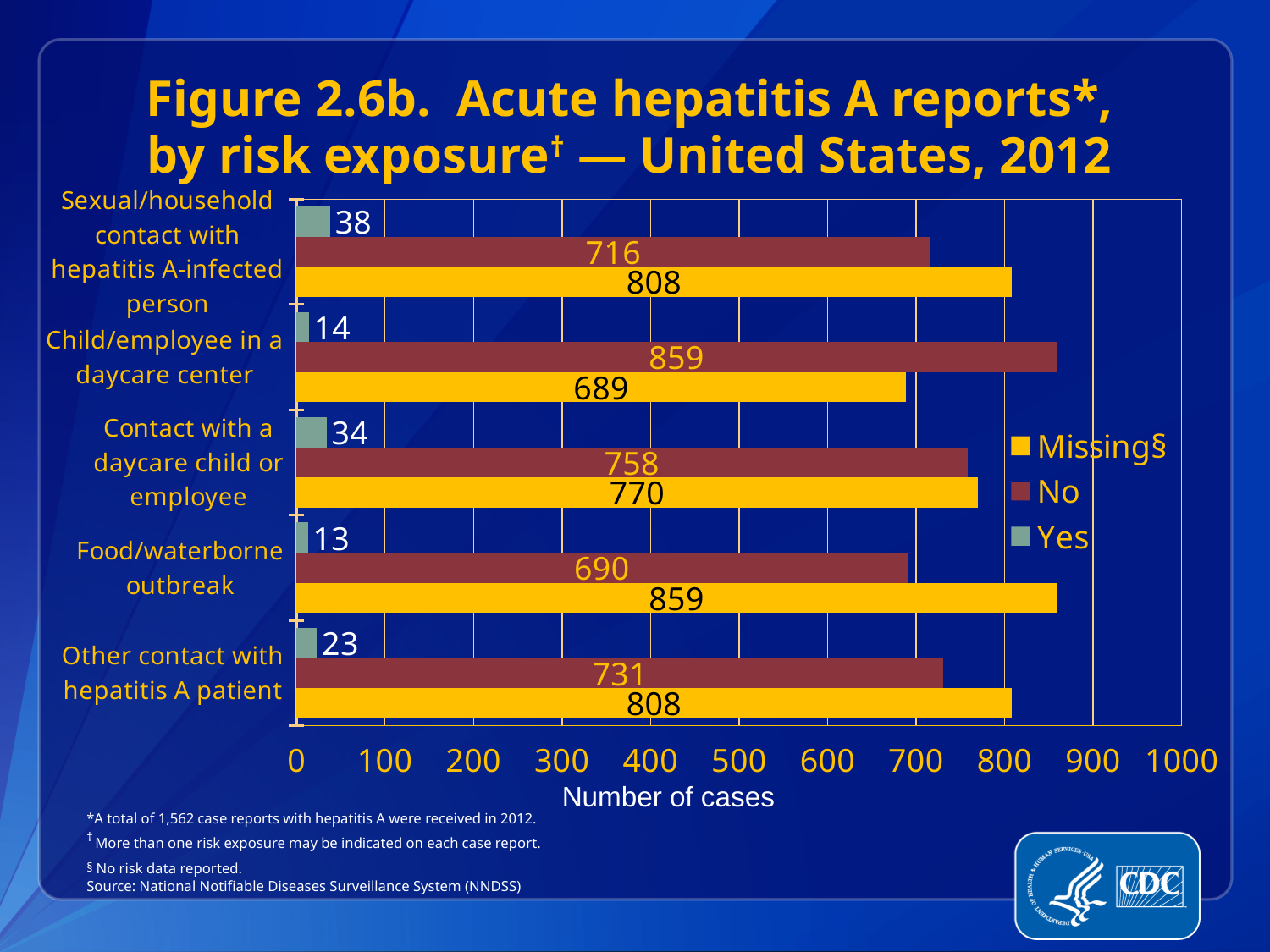
How many series does the legend list? 3 What kind of chart is shown on the slide? Bar chart How many risk exposure categories are shown on the chart? 5 Which risk exposure category has the lowest value in the "Yes" series? Food/waterborne outbreak What is the number of cases in the "No" series for Child/employee in a daycare center? 859 What is the number of cases in the "Yes" series for Sexual/household contact with hepatitis A-infected person? 38 For Contact with a daycare child or employee, which is larger: the "Missing" value or the "No" value? Missing Which risk exposure category has the highest value in the "Yes" series? Sexual/household contact with hepatitis A-infected person What is the number of cases in the "Missing" series for Food/waterborne outbreak? 859 What is the difference between the "No" and "Yes" values for Other contact with hepatitis A patient? 708 What is the total of the "Yes", "No" and "Missing" values for Child/employee in a daycare center? 1,562 What is the label of the x axis? Number of cases